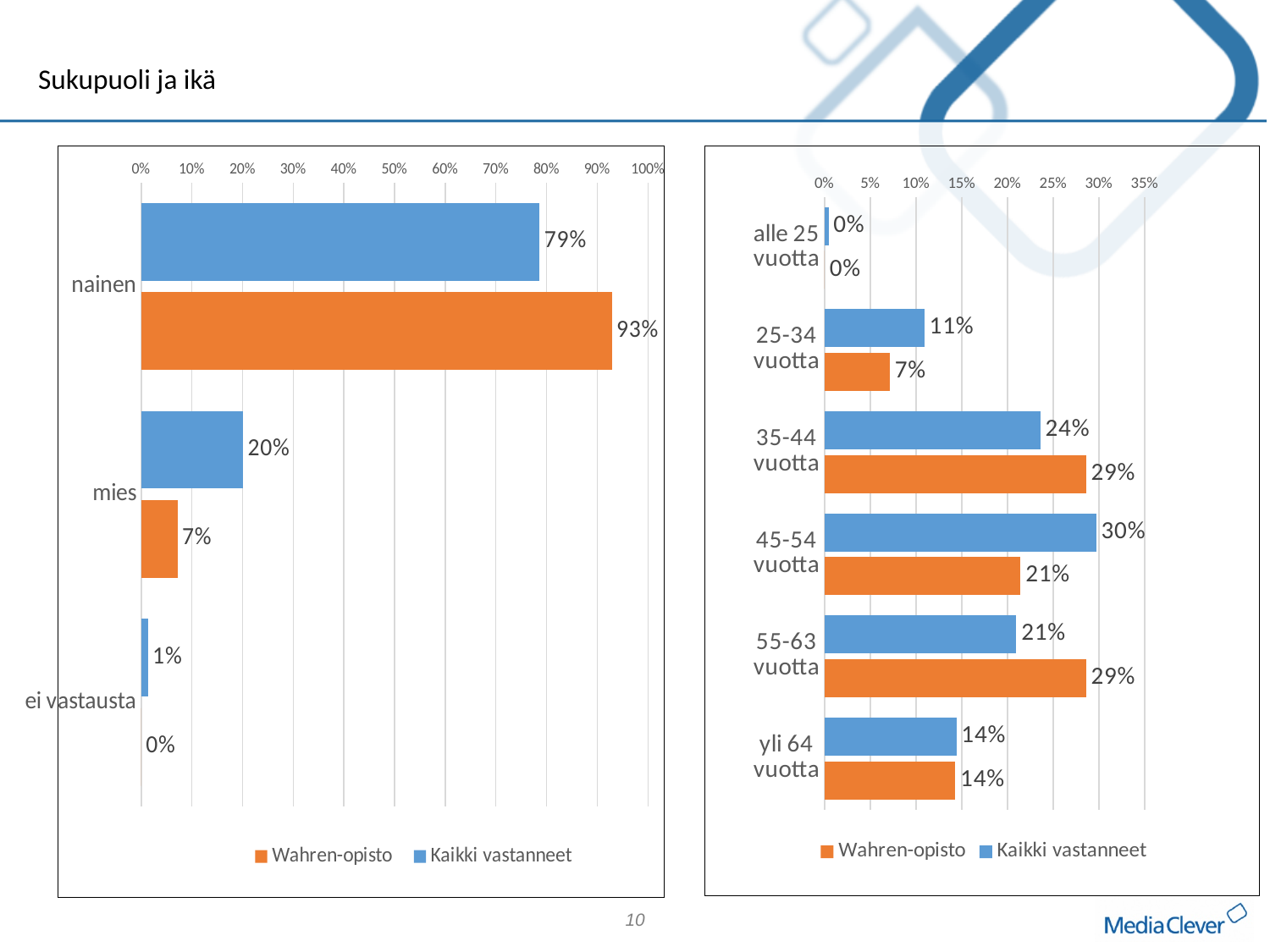
In the right chart, what is the Wahren-opisto value for 55-63 vuotta? 29% In the left chart, what is the Kaikki vastanneet value for mies? 20% In the left chart, which series has the larger value for mies, Wahren-opisto or Kaikki vastanneet? Kaikki vastanneet In the left chart, what is the difference between the Wahren-opisto and Kaikki vastanneet values for nainen? 14 percentage points In the right chart, which colour represents Wahren-opisto? Orange In the right chart, which age group has the highest Kaikki vastanneet value? 45-54 vuotta In the left chart, what is the Wahren-opisto value for nainen? 93% In the right chart, what is the Kaikki vastanneet value for 45-54 vuotta? 30% What type of chart is the left chart? Bar chart In the left chart, how many categories are shown on the vertical axis? 3 In the right chart, how many series does the legend list? 2 In the right chart, what is the difference between the Kaikki vastanneet and Wahren-opisto values for 25-34 vuotta? 4 percentage points